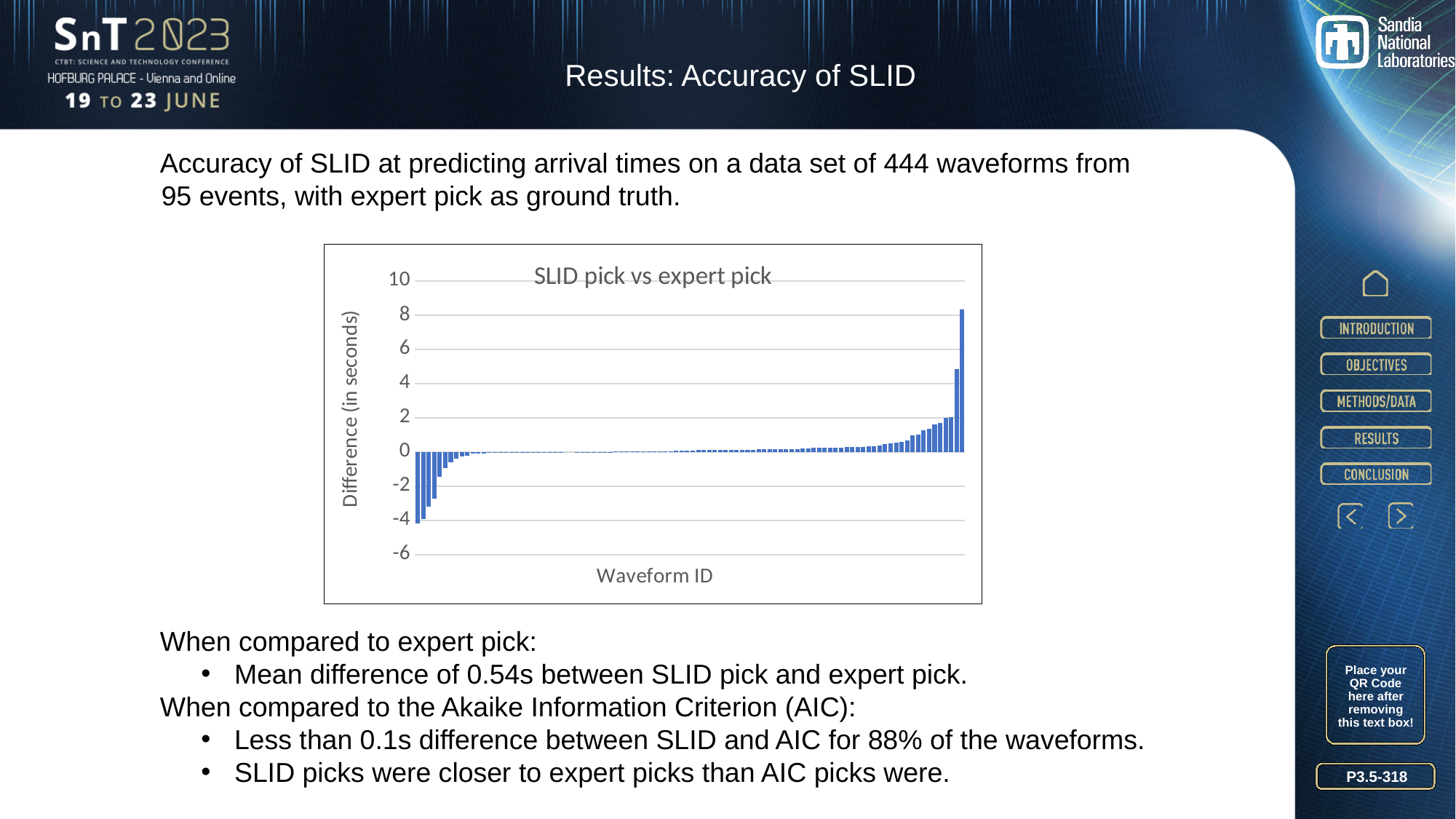
What is the title of the chart? SLID pick vs expert pick Are the bars on the left side of the chart positive or negative? negative Is the value of the leftmost (most negative) bar greater or less than -2? less Is the value of the leftmost bar greater or less than -6? greater Do the bar values rise or fall from left to right along the x axis? rise Is the value of the tallest bar greater or less than 10? less What kind of chart is shown on the slide? bar chart What is the highest tick value shown on the vertical axis? 10 What is the label of the vertical axis of the chart? Difference (in seconds)